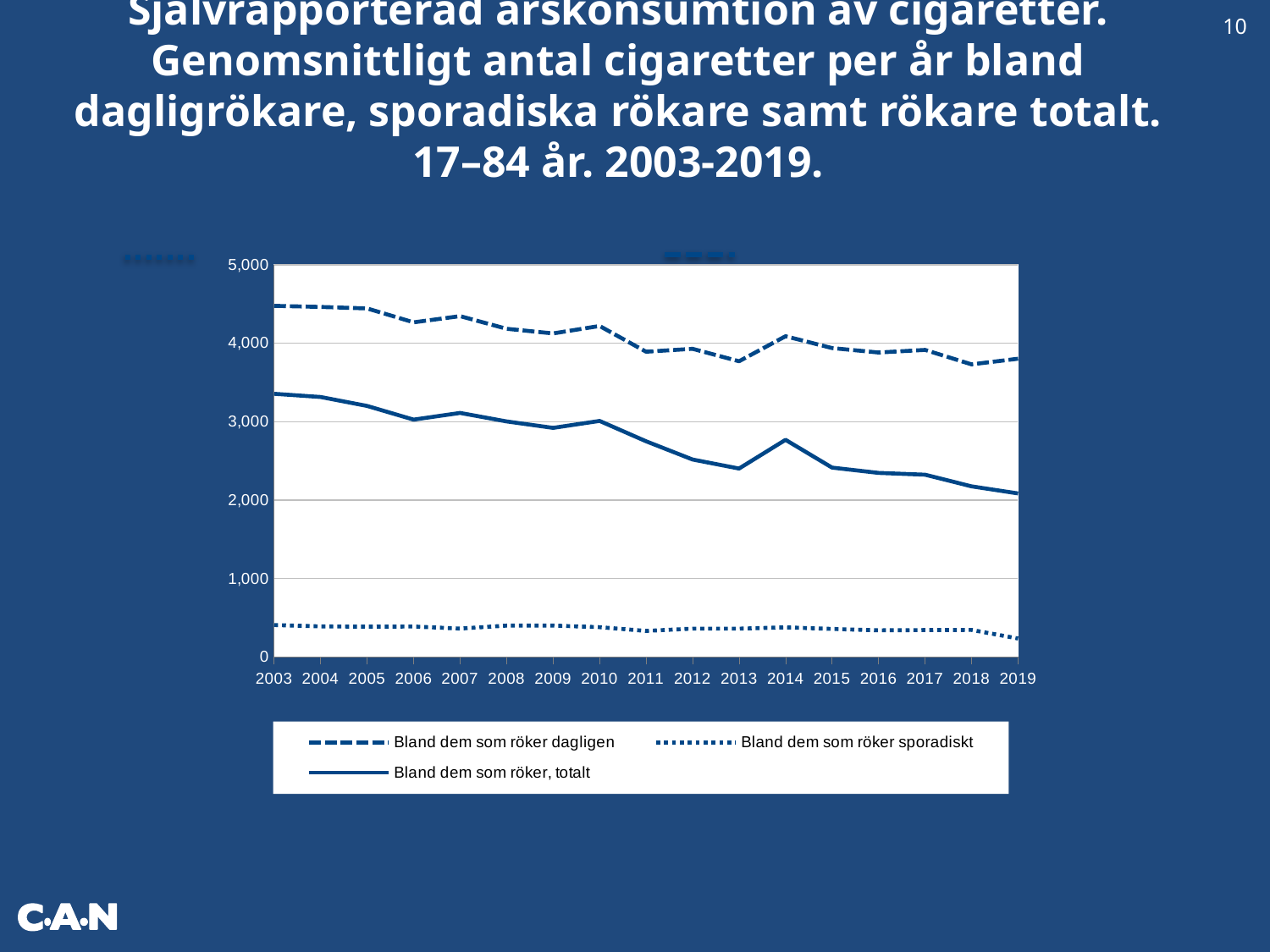
Which series is drawn with a dotted line? Bland dem som röker sporadiskt Which series is drawn with a solid line? Bland dem som röker, totalt Is the value for 'Bland dem som röker sporadiskt' in 2003 greater or less than 1,000? less Is the value for 'Bland dem som röker, totalt' in 2013 greater or less than 3,000? less In 2010, which series has the larger value: 'Bland dem som röker dagligen' or 'Bland dem som röker sporadiskt'? Bland dem som röker dagligen How many years are plotted along the x axis? 17 Is the value for 'Bland dem som röker, totalt' in 2003 greater or less than 3,000? greater How many series does the legend list? 3 Does the value for 'Bland dem som röker, totalt' generally rise or fall from 2003 to 2019? Fall What kind of chart is shown on the slide? Line chart